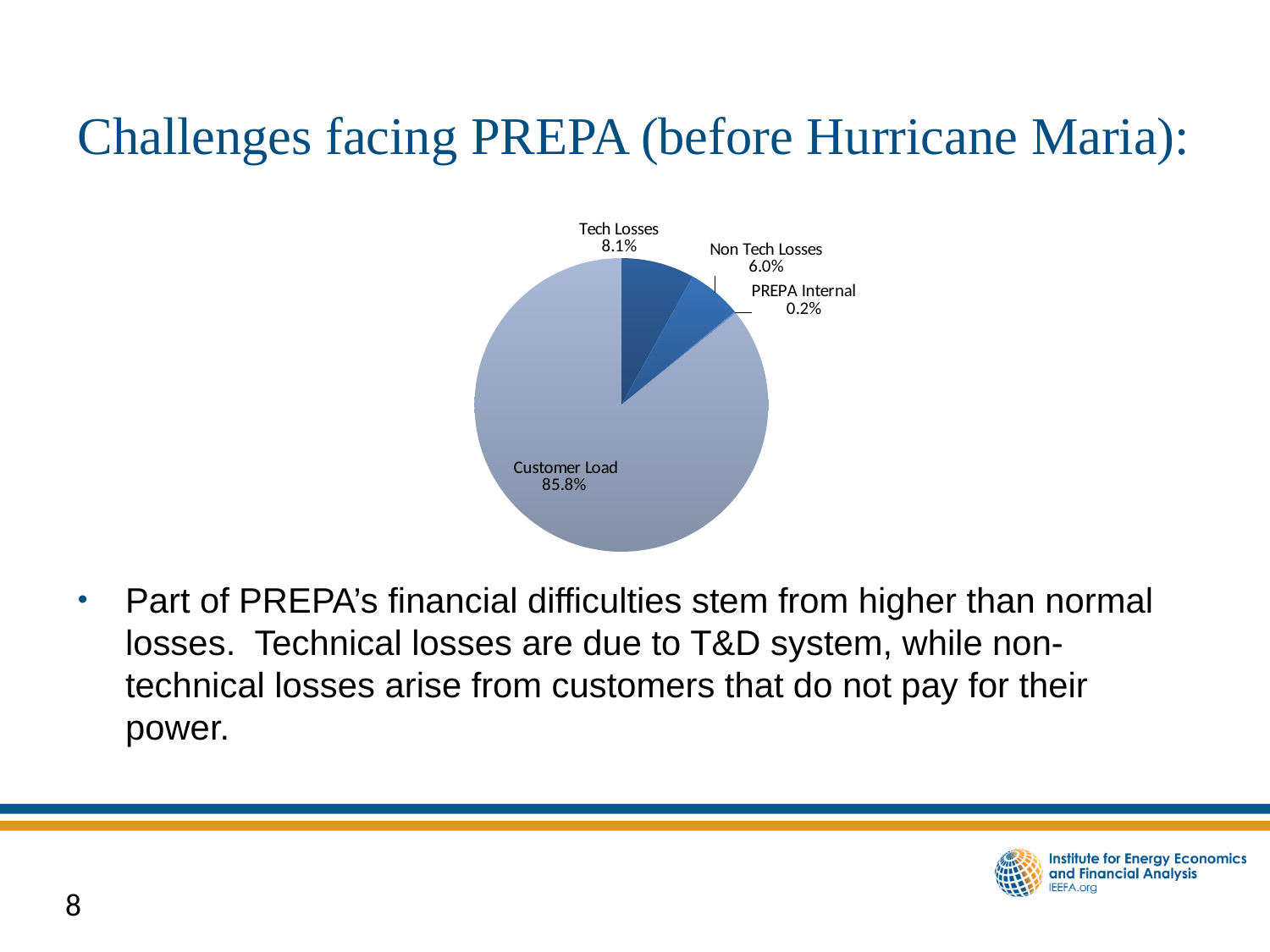
Which slice of the pie is the smallest? PREPA Internal What is the value shown for Tech Losses? 8.1% What is the value shown for Non Tech Losses? 6.0% What is the combined share of Tech Losses and Non Tech Losses? 14.1% What is the title of the slide containing the chart? Challenges facing PREPA (before Hurricane Maria): What is the difference in percentage points between Tech Losses and Non Tech Losses? 2.1 percentage points How many slices does the pie chart have? 4 Which is larger, Tech Losses or Non Tech Losses? Tech Losses What kind of chart is shown on the slide? Pie chart Which slice of the pie is the largest? Customer Load What share of the pie does Customer Load represent? 85.8% What is the value shown for PREPA Internal? 0.2%